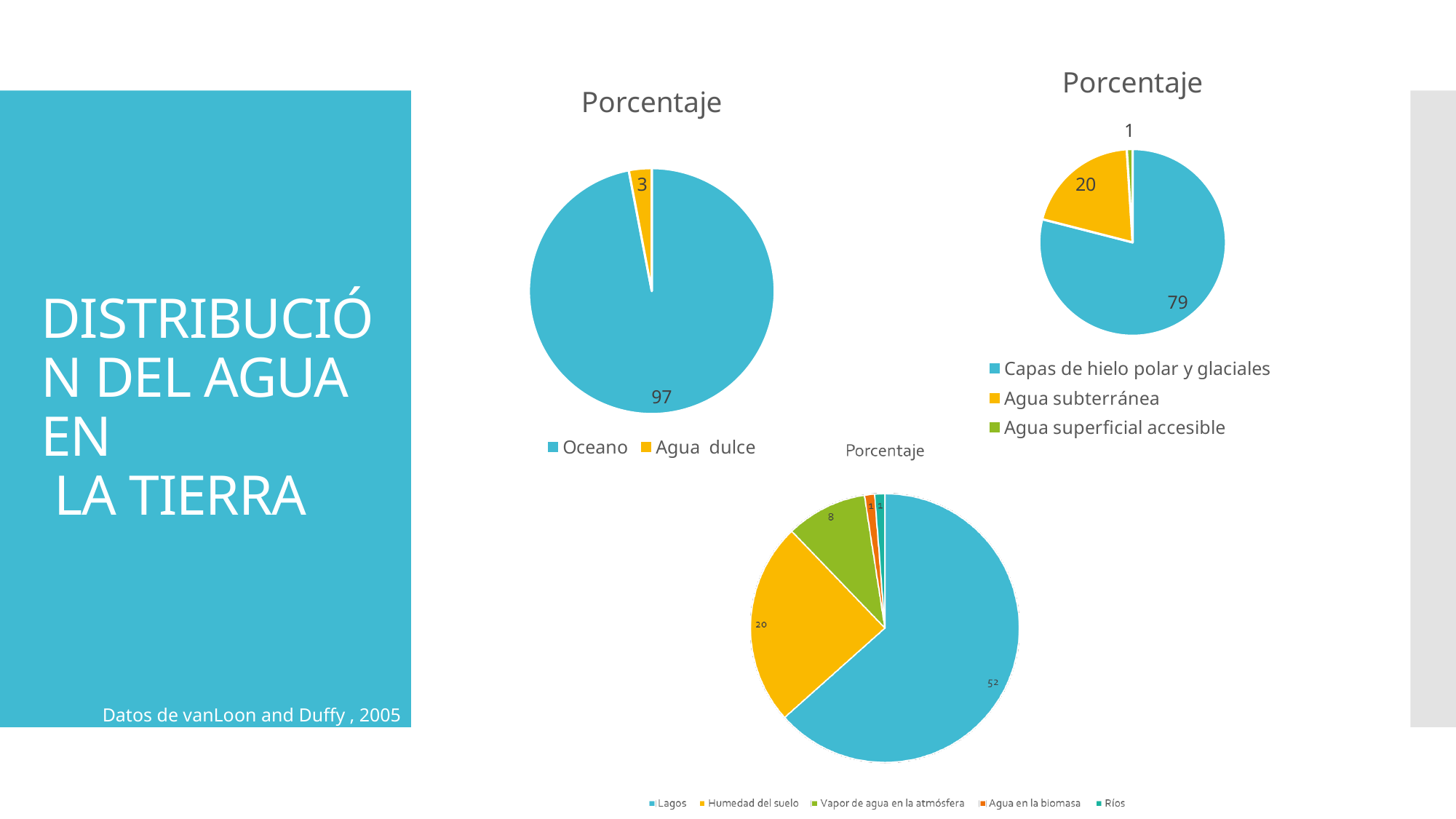
In the bottom pie chart, what is the value for Vapor de agua en la atmósfera? 8 What type of chart is the top-left chart on the slide? Pie chart In the top-left pie chart, what is the value for Oceano? 97 In the top-right pie chart, which category has the smallest slice? Agua superficial accesible How many categories does the legend of the top-right pie chart list? 3 In the top-right pie chart, which category has the largest slice? Capas de hielo polar y glaciales How many categories does the legend of the bottom pie chart list? 5 In the bottom pie chart, which is larger, Humedad del suelo or Vapor de agua en la atmósfera? Humedad del suelo In the top-right pie chart, what is the value for Agua subterránea? 20 In the top-left pie chart, what is the difference between the Oceano and Agua dulce values? 94 In the bottom pie chart, what is the value for Lagos? 52 In the top-left pie chart, what is the value for Agua dulce? 3